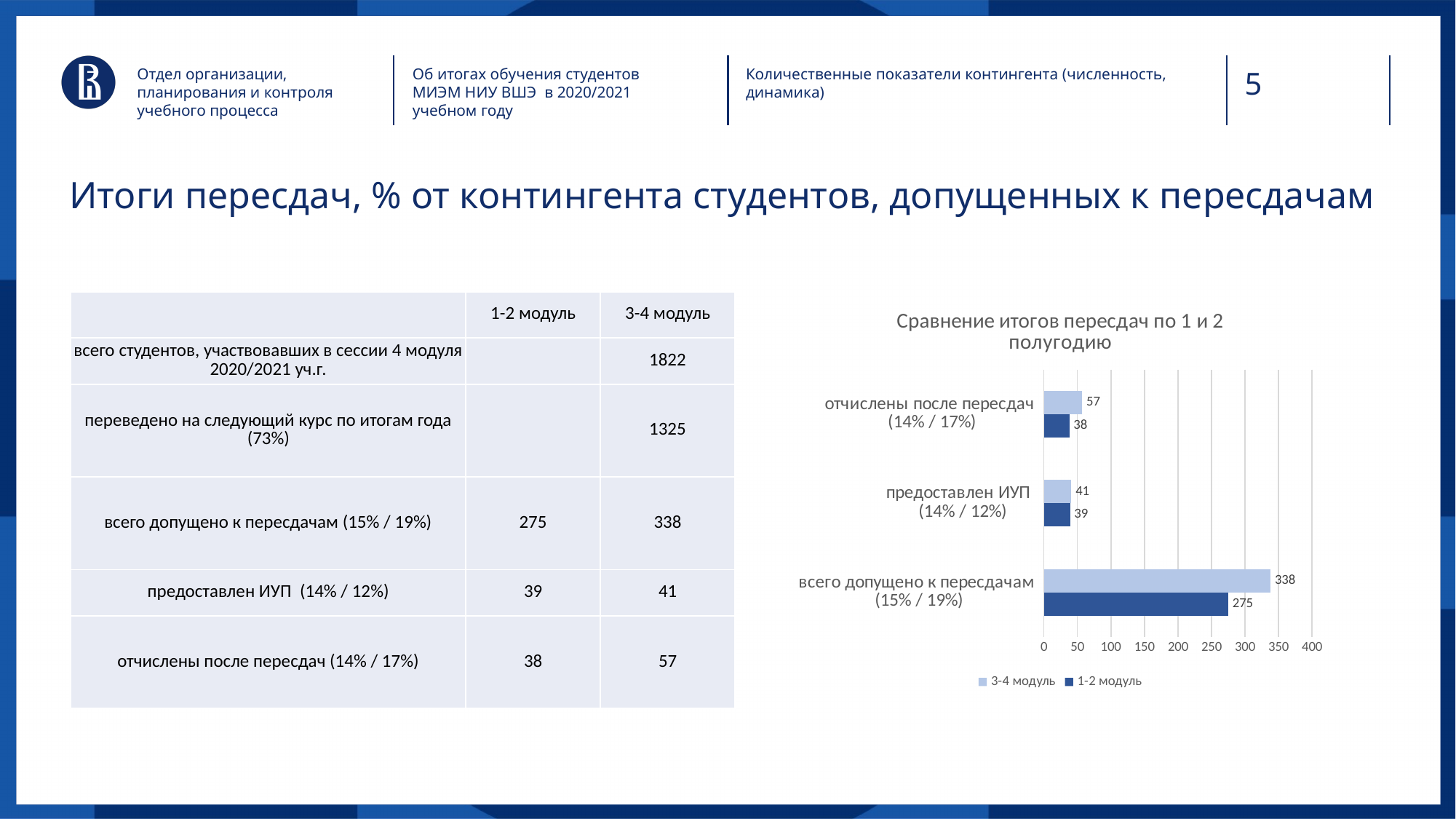
What is the title of the chart on the slide? Сравнение итогов пересдач по 1 и 2 полугодию Which category has the highest value for "3-4 модуль"? всего допущено к пересдачам (15% / 19%) How many categories are shown on the chart? 3 Which is larger for "отчислены после пересдач (14% / 17%)": the "3-4 модуль" value or the "1-2 модуль" value? 3-4 модуль What is the value for "1-2 модуль" in the category "всего допущено к пересдачам (15% / 19%)"? 275 What is the difference between the "3-4 модуль" and "1-2 модуль" values for "всего допущено к пересдачам (15% / 19%)"? 63 What type of chart is shown on the slide? bar chart Is the "3-4 модуль" value for "всего допущено к пересдачам (15% / 19%)" greater or less than 300? greater How many series does the chart legend list? 2 What is the value for "3-4 модуль" in the category "отчислены после пересдач (14% / 17%)"? 57 What is the value for "1-2 модуль" in the category "предоставлен ИУП (14% / 12%)"? 39 Which category has the lowest value for "1-2 модуль"? отчислены после пересдач (14% / 17%)